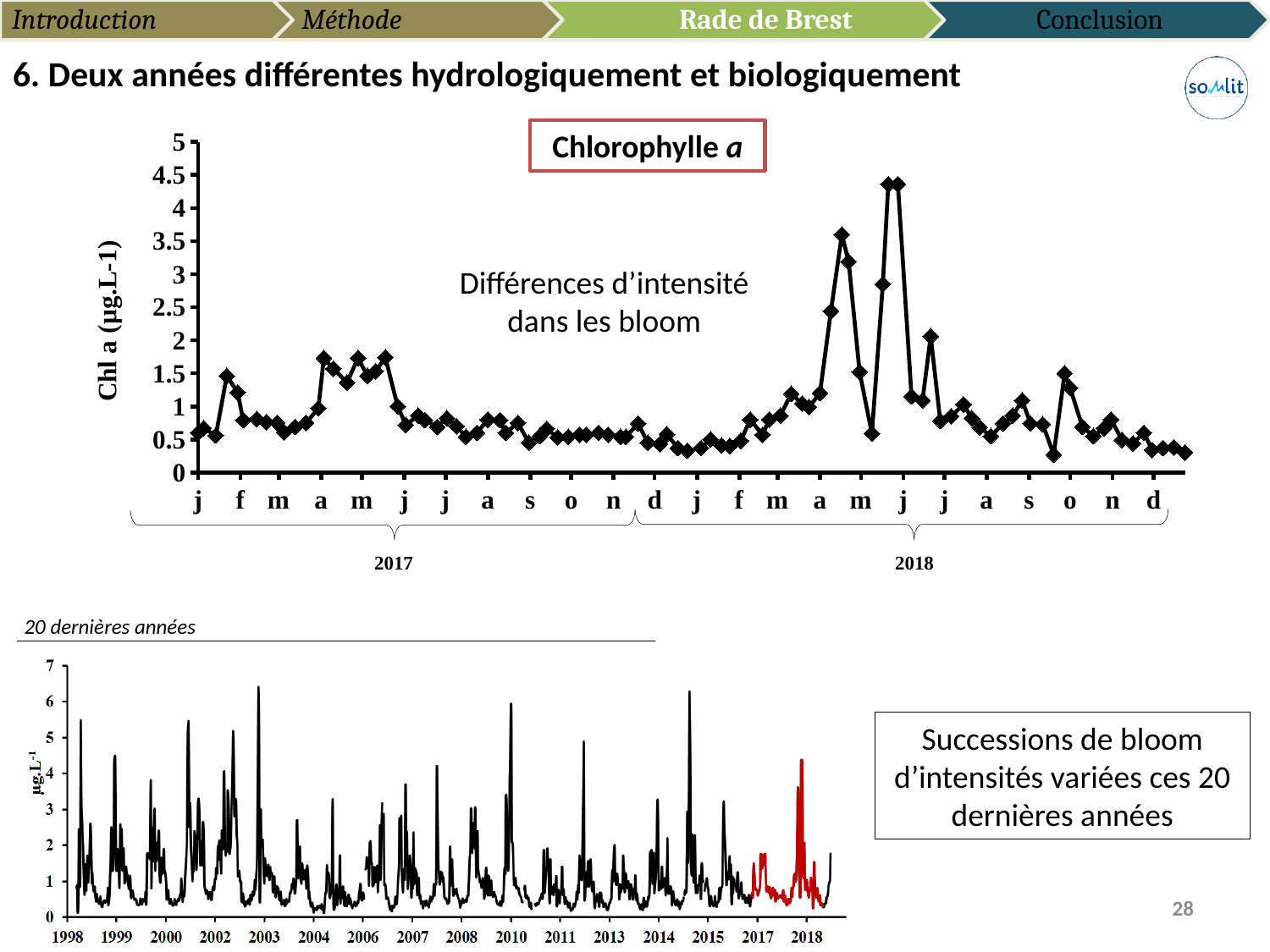
In the bottom chart "20 dernières années", which years are drawn in red? 2017 and 2018 In the top chart "Chlorophylle a", is the highest value reached in 2018 greater or less than 4? greater In the top chart "Chlorophylle a", is the highest value reached in 2017 greater or less than 2? less In the bottom chart "20 dernières années", is the peak in 2003 greater or less than 5? greater In the top chart "Chlorophylle a", which year shows the higher peak, 2017 or 2018? 2018 What is the y-axis label of the top chart "Chlorophylle a"? Chl a (µg.L-1) In the top chart "Chlorophylle a", do the values rise or fall from the June 2018 peak to December 2018? fall What kind of chart is the bottom chart labelled "20 dernières années"? line chart What kind of chart is the top chart titled "Chlorophylle a"? line chart